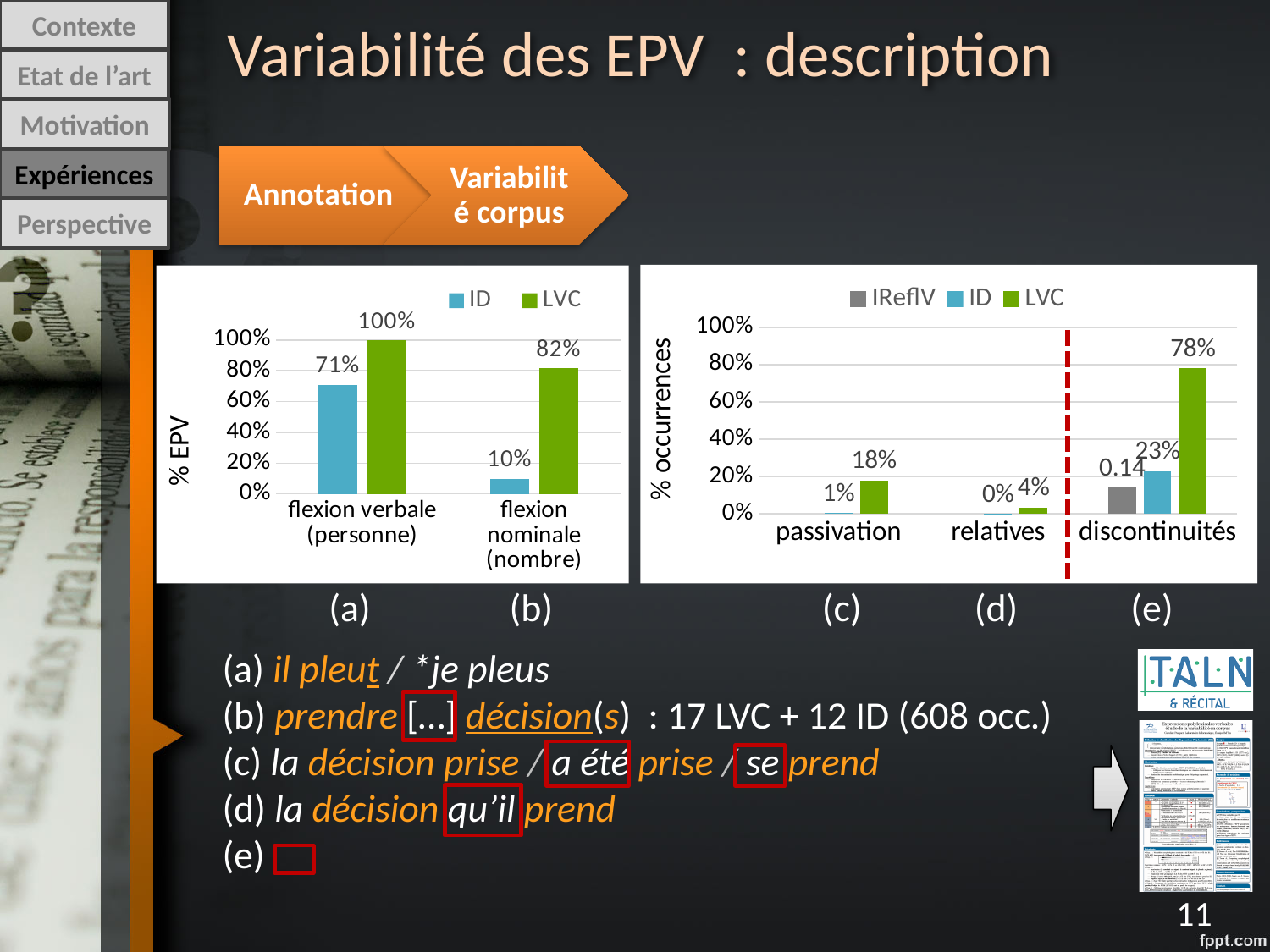
In the left chart (% EPV), which series has the higher value for flexion verbale (personne), ID or LVC? LVC In the left chart (% EPV), how many series does the legend list? 2 In the left chart (% EPV), what is the ID value for flexion verbale (personne)? 71% In the right chart (% occurrences), which category has the highest LVC value? discontinuités In the right chart (% occurrences), what is the ID value for relatives? 0% In the right chart (% occurrences), what is the LVC value for discontinuités? 78% In the right chart (% occurrences), what is the LVC value for passivation? 18% What type of chart is the left chart (% EPV)? bar chart In the left chart (% EPV), what is the difference between the LVC and ID values for flexion nominale (nombre)? 72% In the right chart (% occurrences), how many categories are shown on the x axis? 3 In the right chart (% occurrences), how many series does the legend list? 3 In the left chart (% EPV), what is the LVC value for flexion nominale (nombre)? 82%